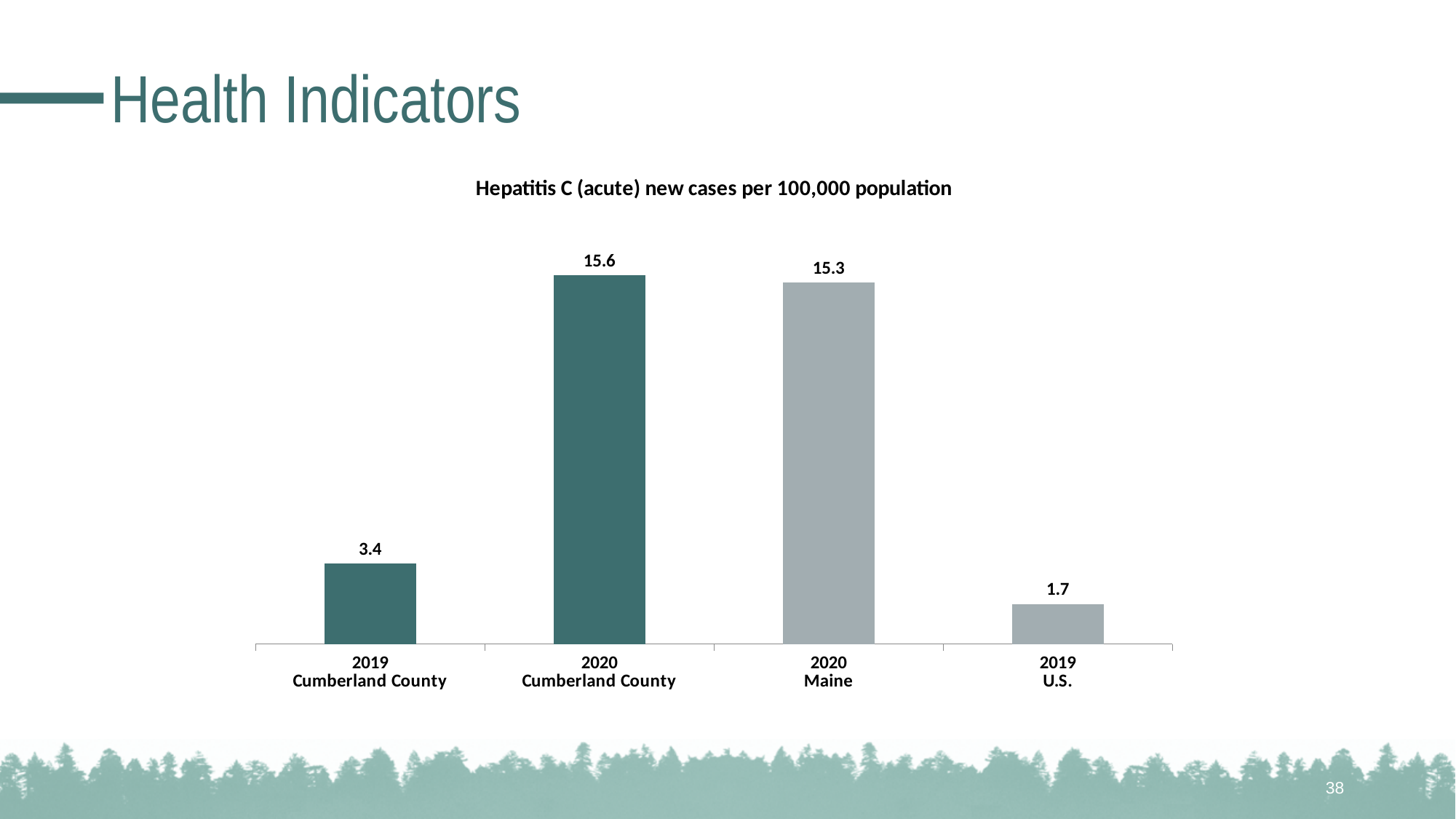
Which is larger, the value for 2019 Cumberland County or the value for 2019 U.S.? 2019 Cumberland County How many bars are shown in the chart? 4 What is the difference between the 2020 Cumberland County value and the 2019 Cumberland County value? 12.2 What is the value for 2020 Maine? 15.3 What is the value for 2019 U.S.? 1.7 What is the difference between the 2019 Cumberland County value and the 2019 U.S. value? 1.7 What is the value for 2019 Cumberland County? 3.4 What is the title of the chart? Hepatitis C (acute) new cases per 100,000 population What kind of chart is shown on the slide? Bar chart Which category has the lowest value? 2019 U.S. Which category has the highest value? 2020 Cumberland County What is the value for 2020 Cumberland County? 15.6